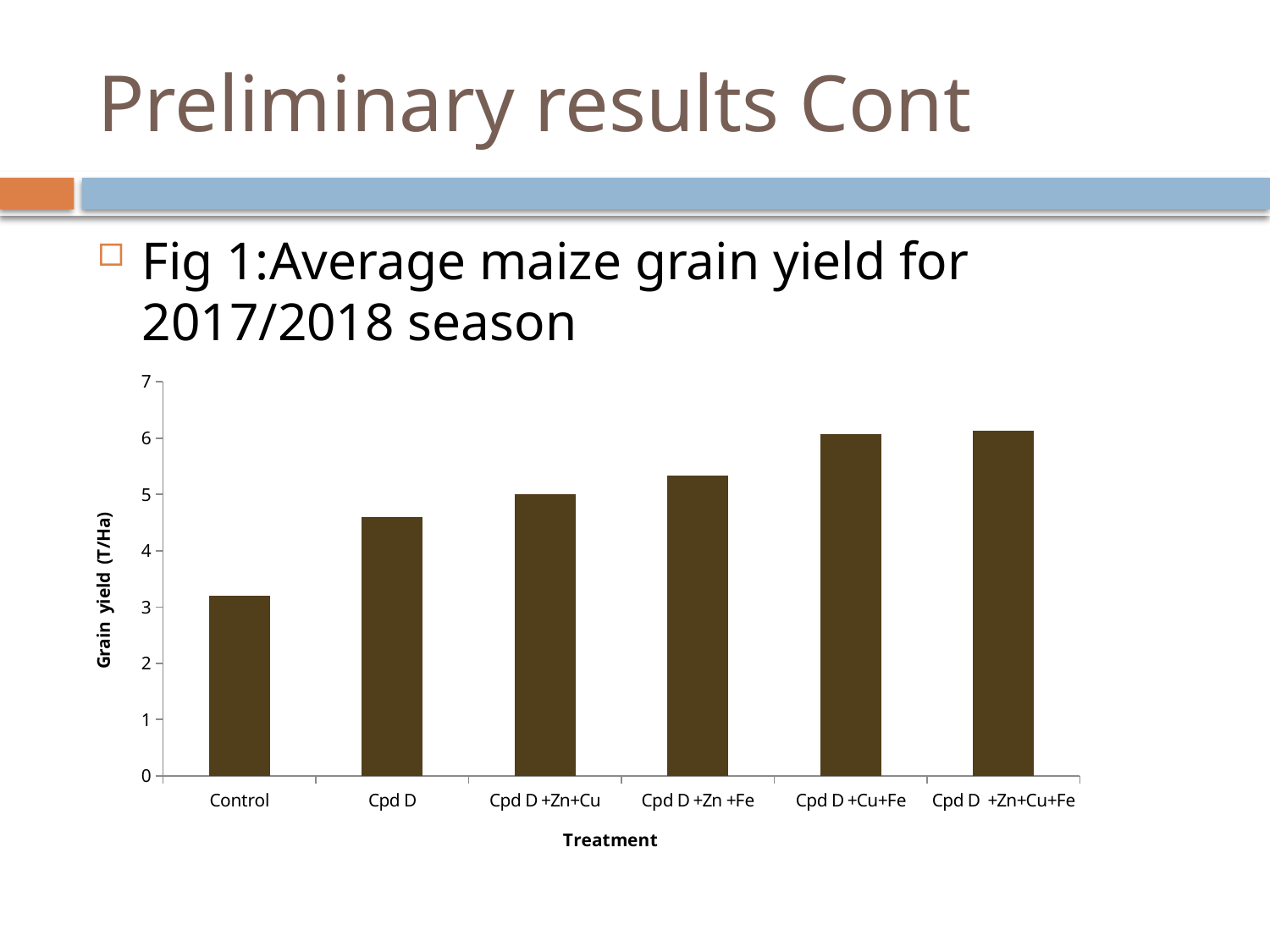
Is the grain yield for Cpd D +Zn +Fe greater or less than 5? greater Which treatment has the lowest grain yield? Control Which has the higher grain yield, Cpd D or Cpd D +Zn +Fe? Cpd D +Zn +Fe Is the grain yield for Control greater or less than 4? less What is the label of the vertical axis? Grain yield (T/Ha) Is the grain yield for Cpd D +Zn+Cu+Fe greater or less than 5? greater Which has the higher grain yield, Control or Cpd D? Cpd D Do the grain yield values rise or fall moving from Control to Cpd D +Zn+Cu+Fe along the x axis? rise How many treatments are plotted on the x axis? 6 What kind of chart is shown on the slide? bar chart